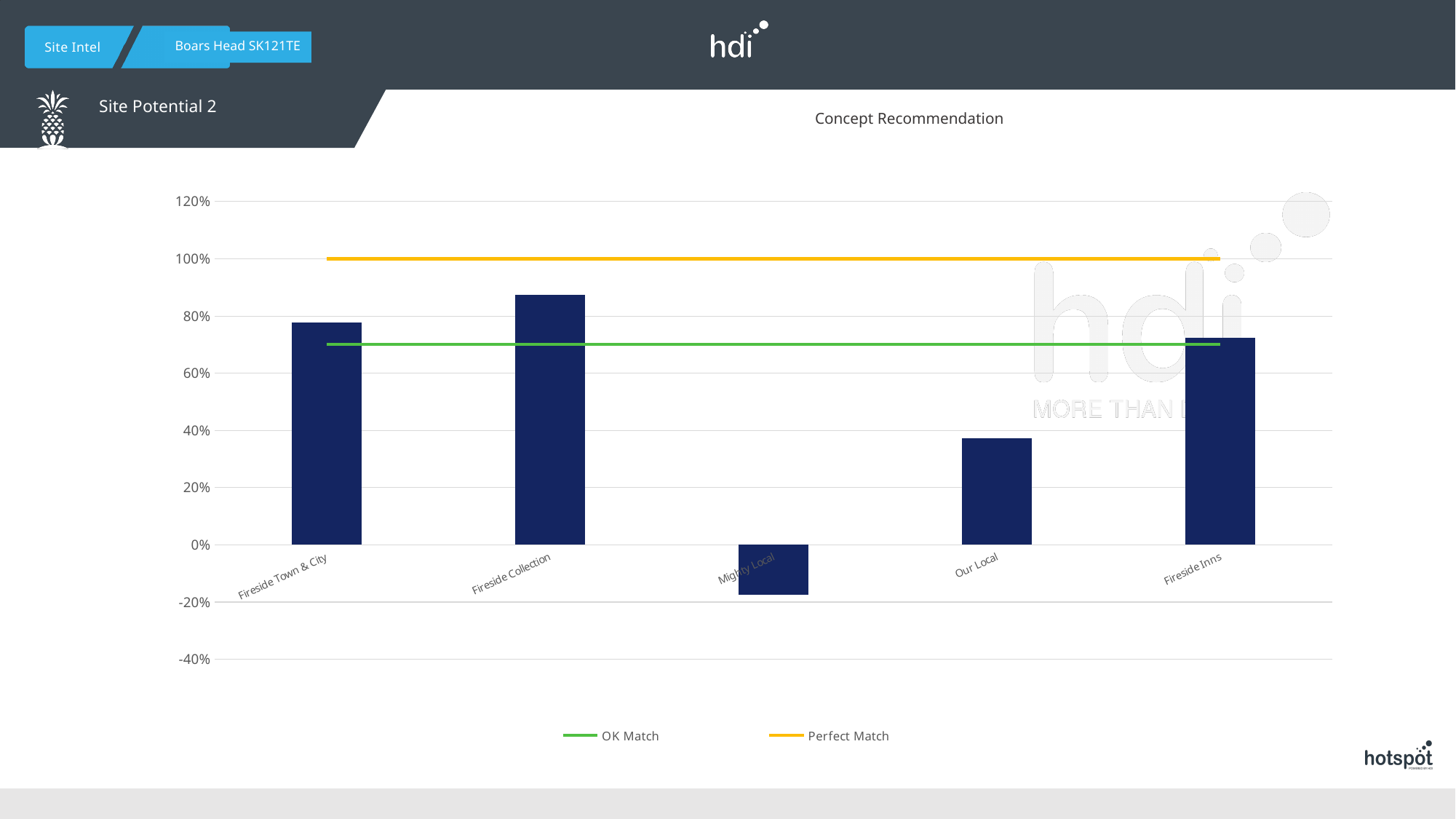
At what level does the Perfect Match line sit on the y axis? 100% What kind of chart is shown on the slide? combination bar and line chart Is the value for Fireside Collection greater or less than 100%? less Which is larger, the value for Fireside Inns or the value for Our Local? Fireside Inns How many series does the legend list? 2 Which category has the lowest bar? Mighty Local How many concept categories are plotted on the x axis? 5 Which category has the highest bar? Fireside Collection What is the title shown above the chart? Concept Recommendation Is the value for Mighty Local greater or less than 0%? less Is the value for Fireside Town & City greater or less than 60%? greater